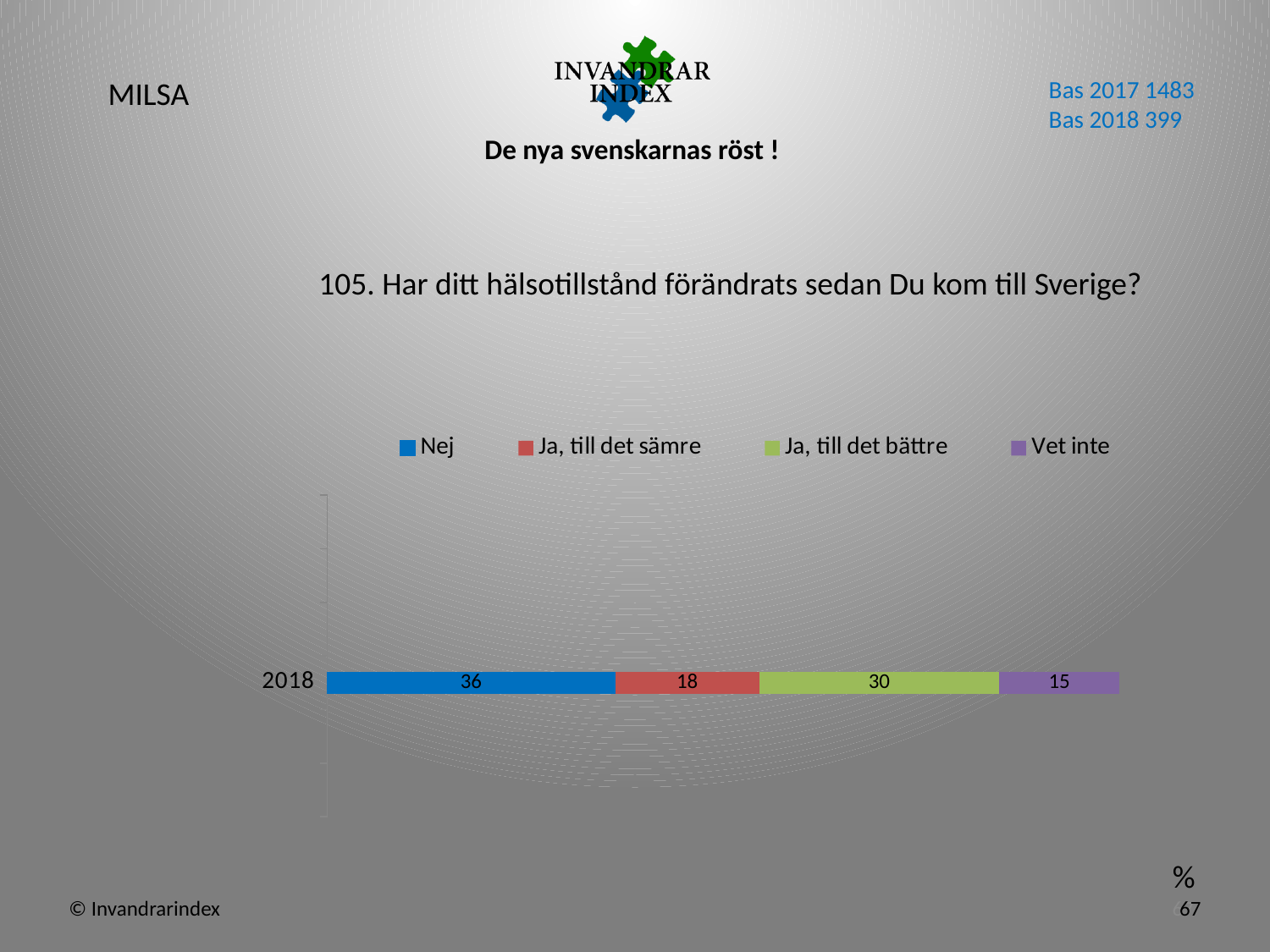
Which series has the highest value in the 2018 bar? Nej Which year is shown on the chart's category axis? 2018 How many series does the legend list? 4 What is the value for "Ja, till det bättre" in the 2018 bar? 30 What is the value for "Ja, till det sämre" in the 2018 bar? 18 What is the value for "Nej" in the 2018 bar? 36 What is the difference between the "Nej" and "Ja, till det bättre" values for 2018? 6 What is the total of the stacked bar for 2018? 99 What is the value for "Vet inte" in the 2018 bar? 15 Which series has the lowest value in the 2018 bar? Vet inte What kind of chart is shown on the slide? Stacked bar chart Which is larger for 2018: "Ja, till det sämre" or "Ja, till det bättre"? Ja, till det bättre